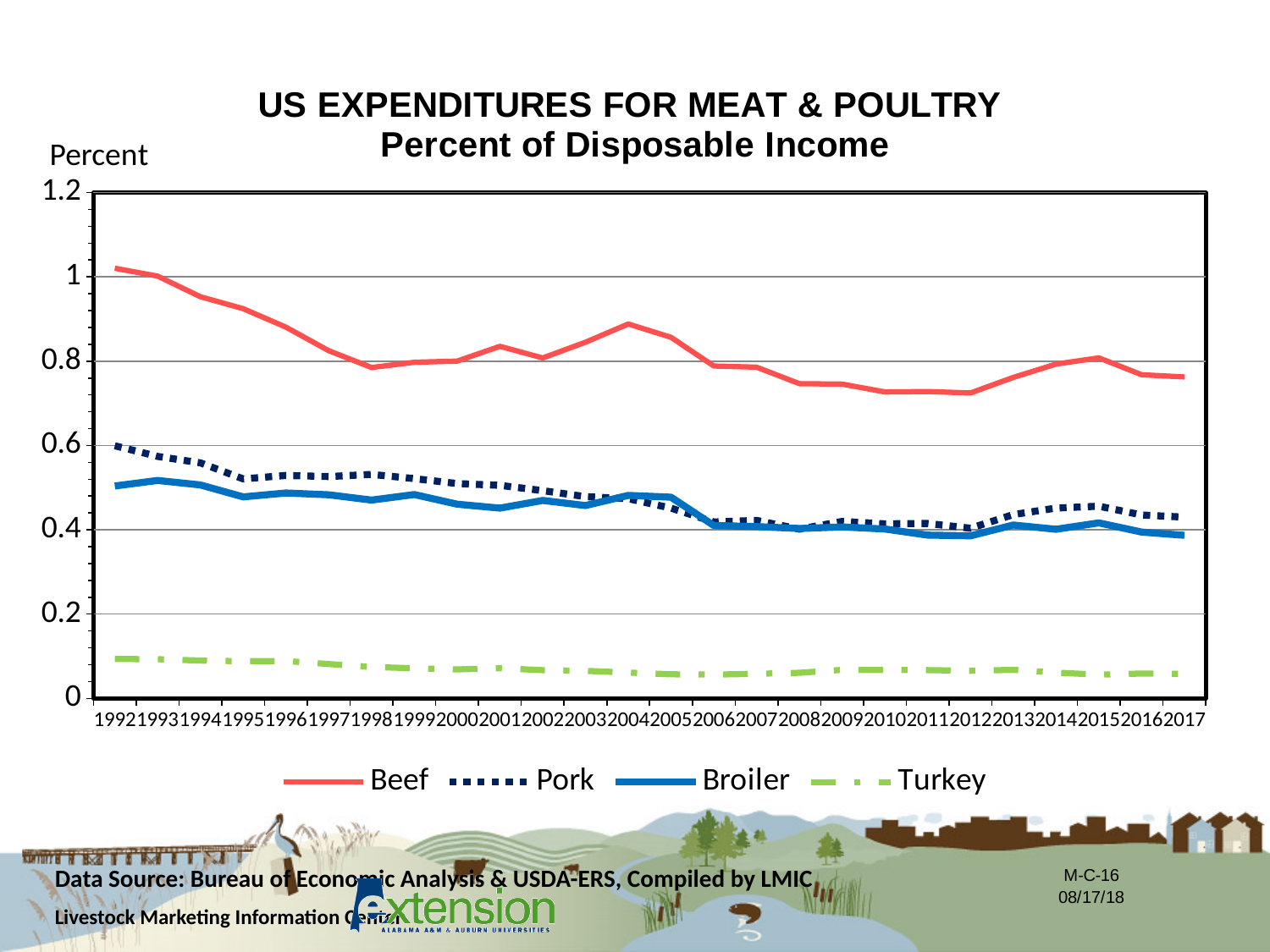
Is the value for Pork in 1992 greater or less than 0.4? greater Is the value for Beef in 2004 greater or less than 0.8? greater Is the value for Turkey in 2017 greater or less than 0.2? less What is the label on the y axis? Percent Which series has the lowest values across the whole period? Turkey Which is larger in 1992, the value for Pork or the value for Broiler? Pork How many series does the legend list? 4 How many years are plotted along the x axis? 26 What kind of chart is shown on the slide? Line chart Which series has the highest values across the whole period? Beef Does the Beef series generally rise or fall from 1992 to 2017? Fall